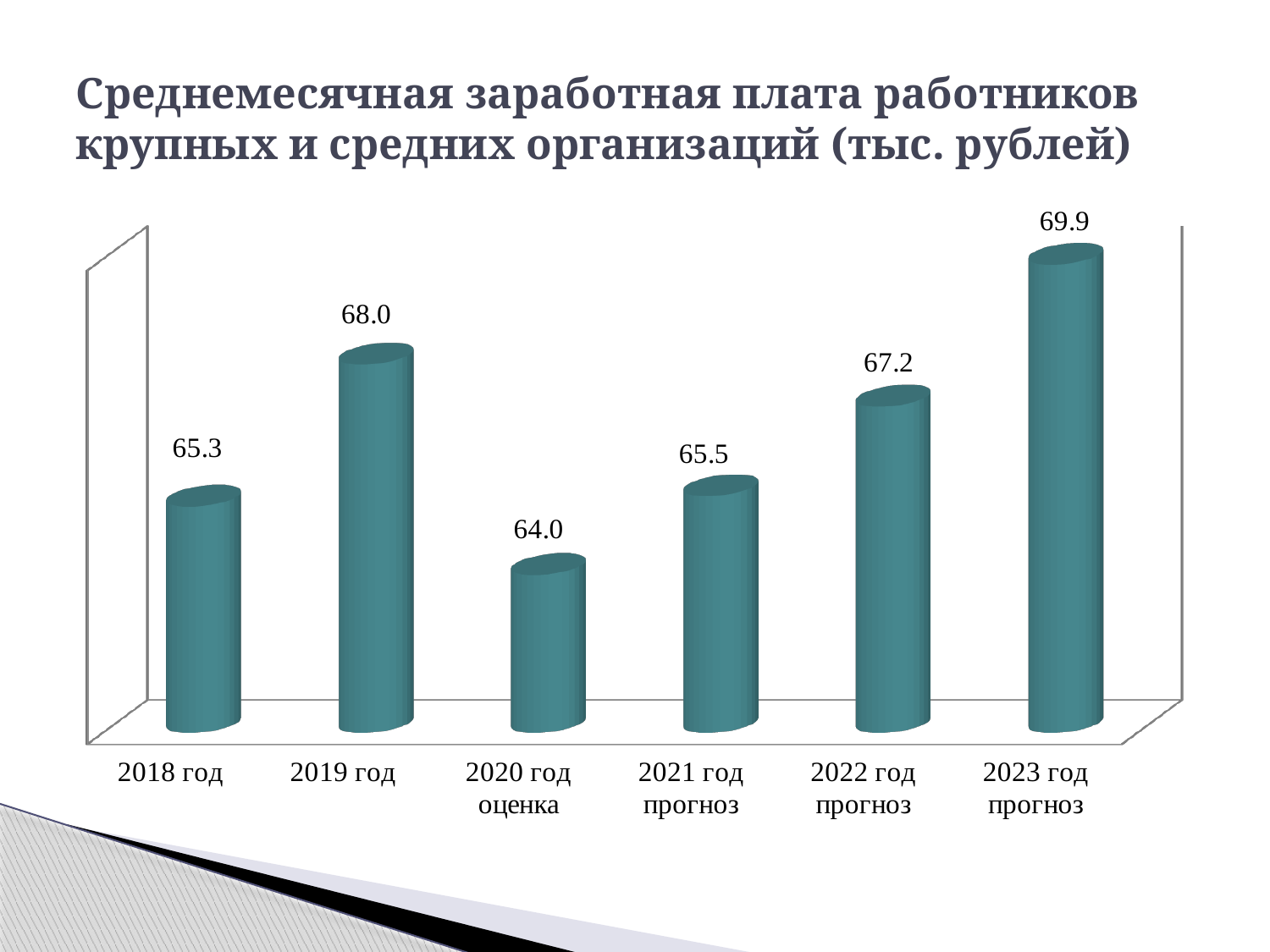
What kind of chart is shown on the slide? bar chart What is the value for 2023 год прогноз? 69.9 What is the value for 2018 год? 65.3 Which category has the lowest value? 2020 год оценка Do the values rise or fall from 2020 год оценка to 2023 год прогноз? rise How many categories are shown on the chart? 6 What is the difference between the values for 2019 год and 2020 год оценка? 4.0 Which is larger, the value for 2019 год or the value for 2021 год прогноз? 2019 год What is the value for 2020 год оценка? 64.0 What is the difference between the values for 2023 год прогноз and 2022 год прогноз? 2.7 Which category has the highest value? 2023 год прогноз What is the value for 2019 год? 68.0